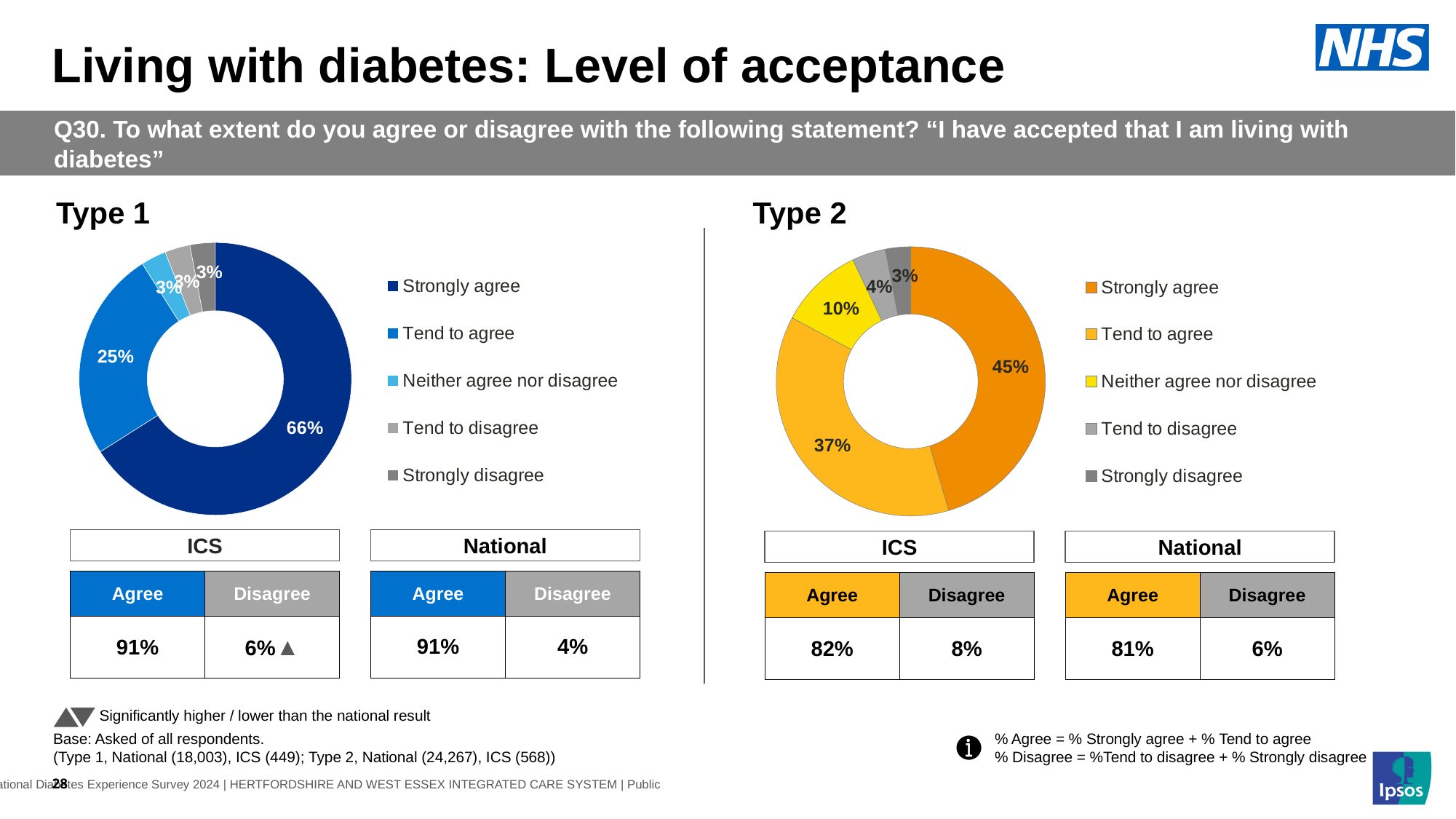
In the Type 2 chart, which response category has the smallest share? Strongly disagree In the Type 2 chart, which is larger: Neither agree nor disagree or Tend to disagree? Neither agree nor disagree In the Type 2 chart, what is the difference between the Strongly agree and Tend to agree percentages? 8% What colour represents Strongly agree in the Type 2 chart? Orange In the Type 1 chart, which response category has the largest share? Strongly agree What type of chart is used for Type 2? Donut chart How many response categories does the legend of the Type 1 chart list? 5 In the Type 2 chart, what percentage of respondents said they tend to agree? 37% In the Type 1 chart, what percentage of respondents said they strongly agree? 66% Which chart shows a larger Strongly agree share, Type 1 or Type 2? Type 1 In the Type 2 chart, what percentage of respondents said they neither agree nor disagree? 10% In the Type 1 chart, what is the difference between the Strongly agree and Tend to agree percentages? 41%